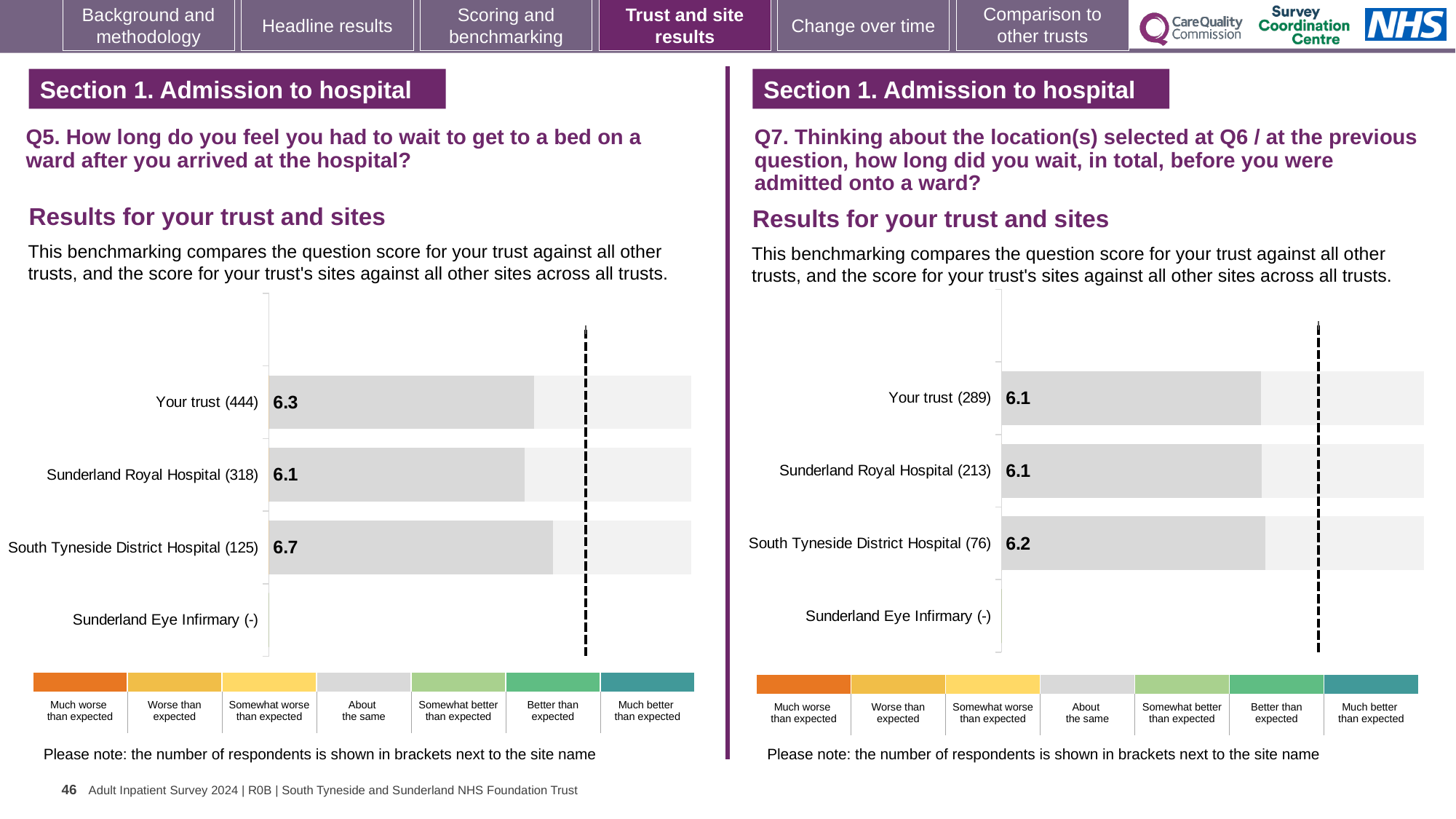
In the Q7 chart on the right, what is the score for South Tyneside District Hospital? 6.2 In the Q5 chart on the left, which row with a plotted score has the lowest score? Sunderland Royal Hospital In the Q7 chart on the right, what is the score for Sunderland Royal Hospital? 6.1 In the Q7 chart on the right, how many respondents are shown in brackets for Your trust? 289 In the Q5 chart on the left, which site or trust row has the highest score? South Tyneside District Hospital In the Q5 chart on the left, what is the score for South Tyneside District Hospital? 6.7 In the Q5 chart on the left, how many respondents are shown in brackets for Your trust? 444 Is the score for Your trust in the Q5 chart on the left larger or smaller than the score for Your trust in the Q7 chart on the right? larger In the Q7 chart on the right, which row has the highest score? South Tyneside District Hospital In the Q5 chart on the left, what is the difference between the scores for South Tyneside District Hospital and Sunderland Royal Hospital? 0.6 What kind of chart is used in the Q5 chart on the left? bar chart In the Q5 chart on the left, what is the score for Your trust? 6.3